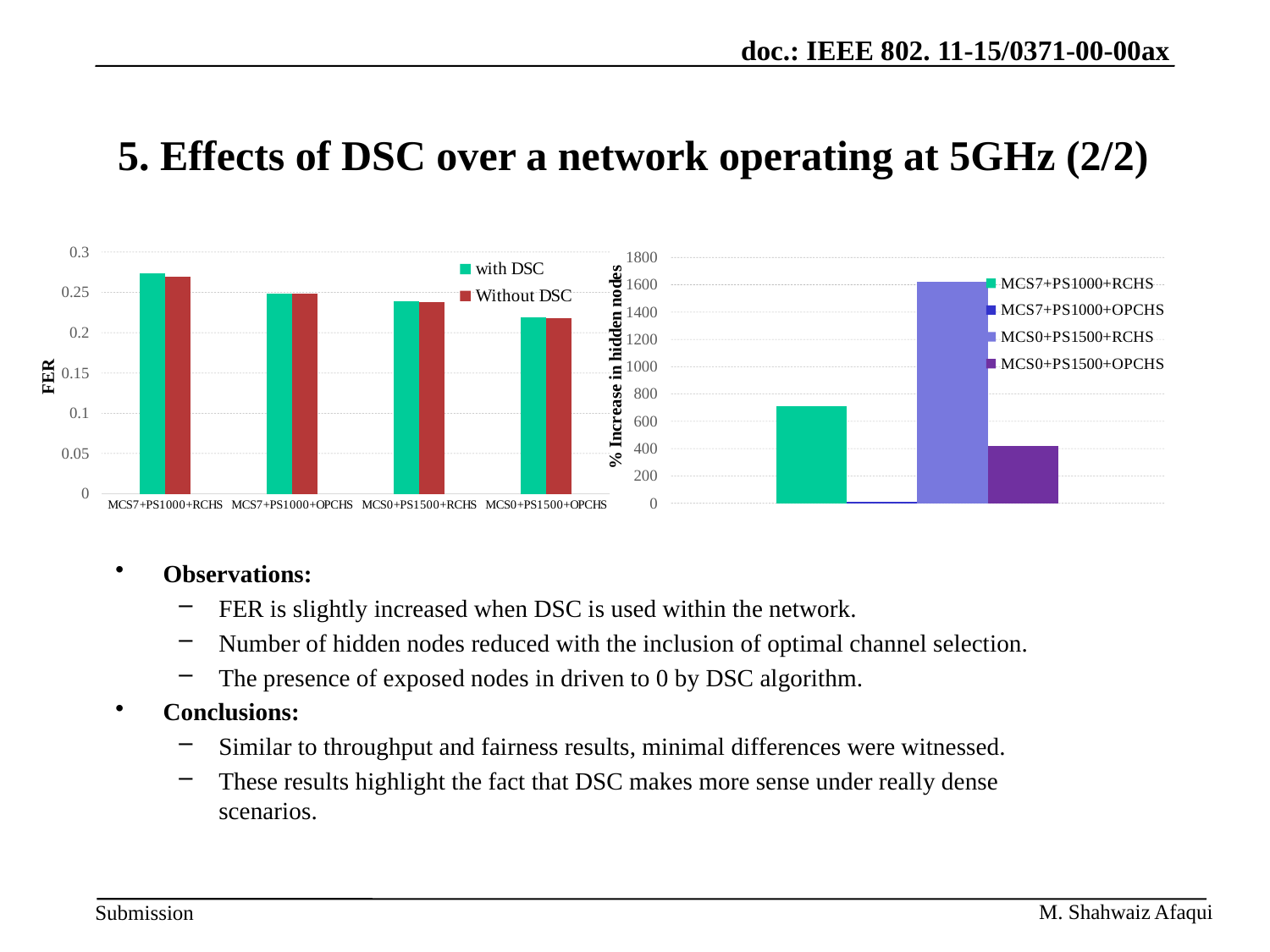
What kind of chart is the left chart (FER)? bar chart In the right chart (% Increase in hidden nodes), which series has the highest value? MCS0+PS1500+RCHS In the left chart (FER), is the 'with DSC' value for MCS7+PS1000+RCHS greater or less than 0.25? greater In the right chart (% Increase in hidden nodes), is the value for MCS7+PS1000+RCHS greater or less than 600? greater In the right chart (% Increase in hidden nodes), which series has the lowest value? MCS7+PS1000+OPCHS How many series does the legend of the left chart (FER) list? 2 How many series does the legend of the right chart (% Increase in hidden nodes) list? 4 In the right chart (% Increase in hidden nodes), which is larger: the value for MCS7+PS1000+RCHS or the value for MCS0+PS1500+OPCHS? MCS7+PS1000+RCHS In the left chart (FER), which category has the lowest FER value? MCS0+PS1500+OPCHS In the left chart (FER), is the 'with DSC' value for MCS0+PS1500+OPCHS greater or less than 0.25? less How many categories are shown on the x axis of the left chart (FER)? 4 In the left chart (FER), which category has the highest FER value? MCS7+PS1000+RCHS